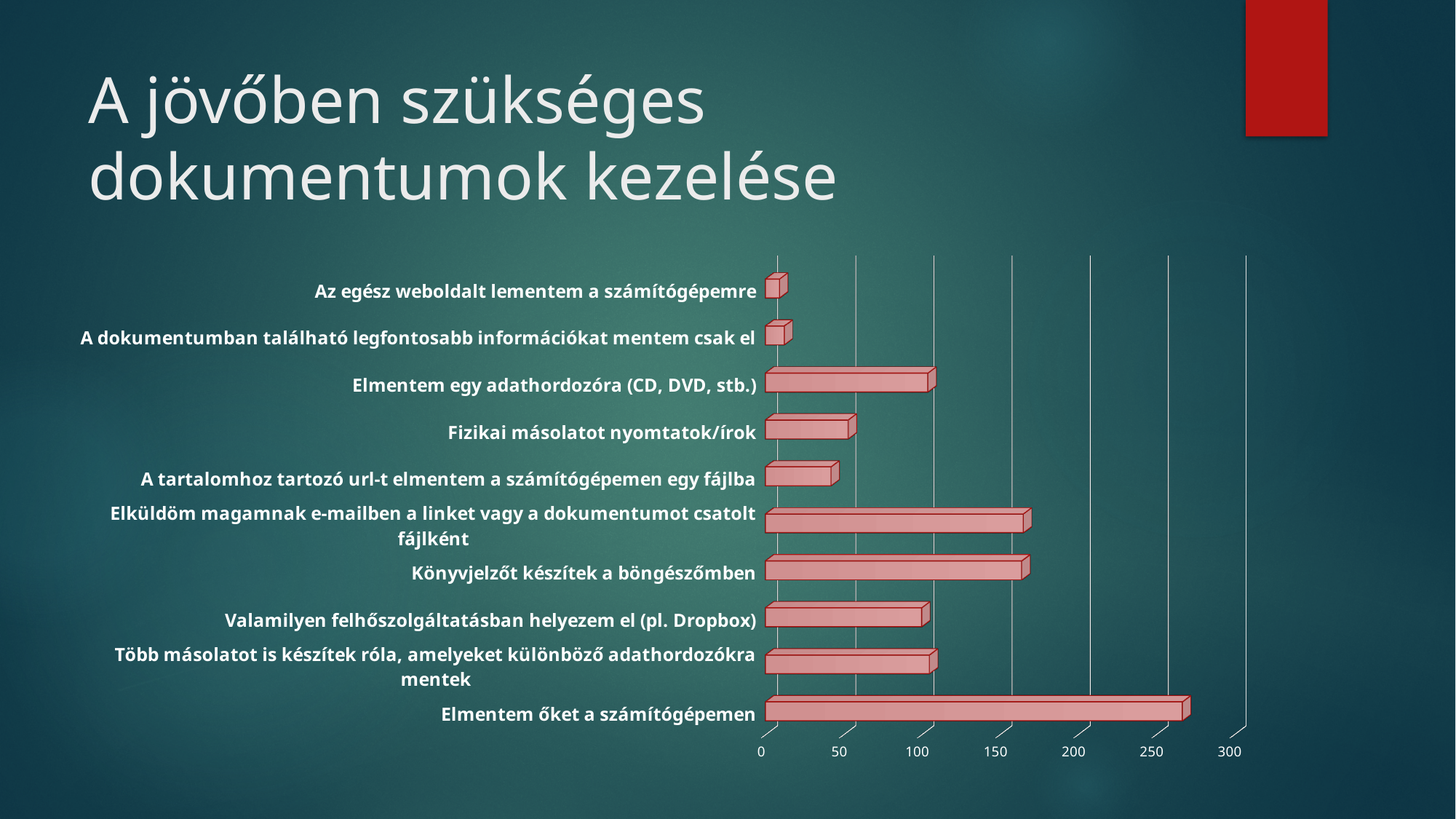
Is the value for "Elküldöm magamnak e-mailben a linket vagy a dokumentumot csatolt fájlként" greater or less than 150? greater Is the value for "A tartalomhoz tartozó url-t elmentem a számítógépemen egy fájlba" greater or less than 50? less Which category has the highest value? Elmentem őket a számítógépemen Is the value for "Elmentem őket a számítógépemen" greater or less than 250? greater Which is larger: the value for "Elmentem egy adathordozóra (CD, DVD, stb.)" or for "Fizikai másolatot nyomtatok/írok"? Elmentem egy adathordozóra (CD, DVD, stb.) How many categories does the chart show? 10 Which is larger: the value for "Könyvjelzőt készítek a böngészőmben" or for "Valamilyen felhőszolgáltatásban helyezem el (pl. Dropbox)"? Könyvjelzőt készítek a böngészőmben What kind of chart is shown on the slide? bar chart What is the title of the slide containing the chart? A jövőben szükséges dokumentumok kezelése